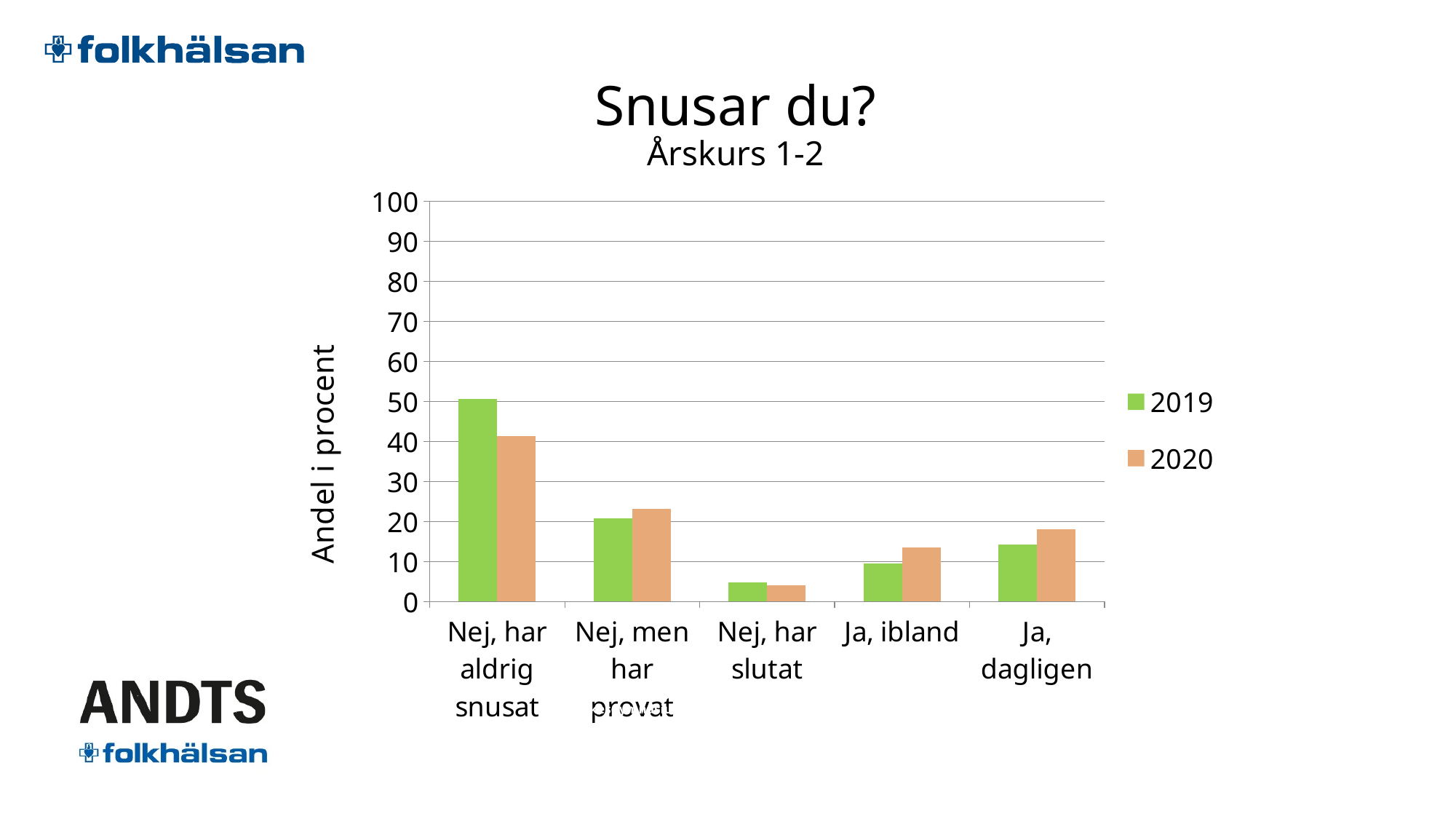
What kind of chart is shown on the slide? bar chart Which category has the lowest value for 2020? Nej, har slutat Which category has the highest value for 2019? Nej, har aldrig snusat How many categories are shown on the x axis? 5 What is the label of the y axis? Andel i procent Is the 2020 value for 'Ja, dagligen' greater or less than 20? less Is the 2019 value for 'Nej, har aldrig snusat' greater or less than 40? greater Which category has the lowest value for 2019? Nej, har slutat For 'Nej, har aldrig snusat', which year has the larger value, 2019 or 2020? 2019 Is the 2019 value for 'Nej, har slutat' greater or less than 10? less How many series does the legend list? 2 For 'Ja, dagligen', which year has the larger value, 2019 or 2020? 2020